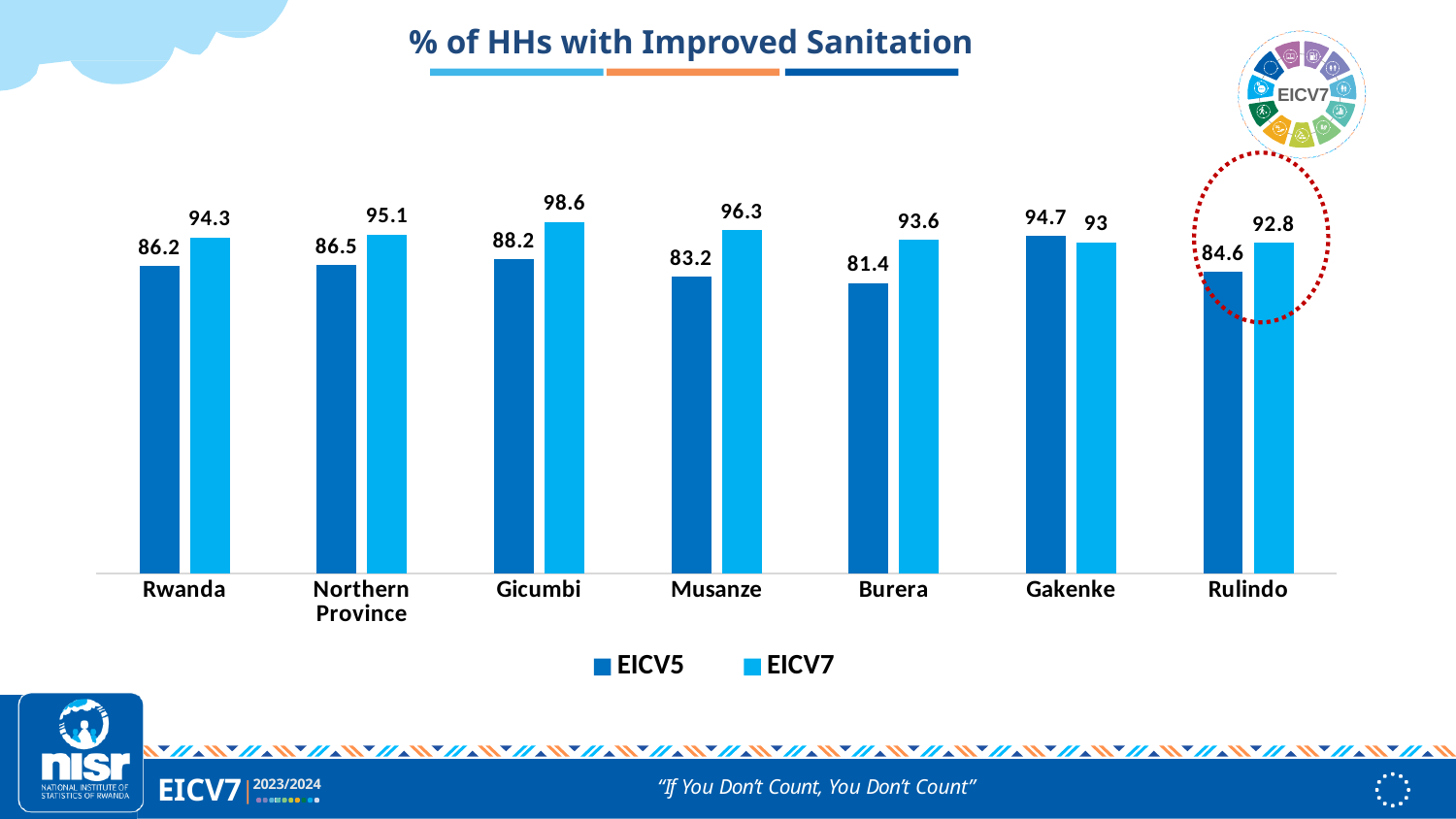
Which category has the lowest EICV5 value? Burera What is the EICV5 value for Rwanda? 86.2 Which category has the highest EICV7 value? Gicumbi How many series does the legend list? 2 What kind of chart is shown on the slide? Bar chart What is the EICV7 value for Gicumbi? 98.6 What is the difference between the EICV7 and EICV5 values for Musanze? 13.1 What is the EICV5 value for Burera? 81.4 What is the EICV7 value for Rulindo? 92.8 How many categories are shown on the x axis? 7 Which is larger for Gakenke, the EICV5 value or the EICV7 value? EICV5 What is the title of the chart? % of HHs with Improved Sanitation